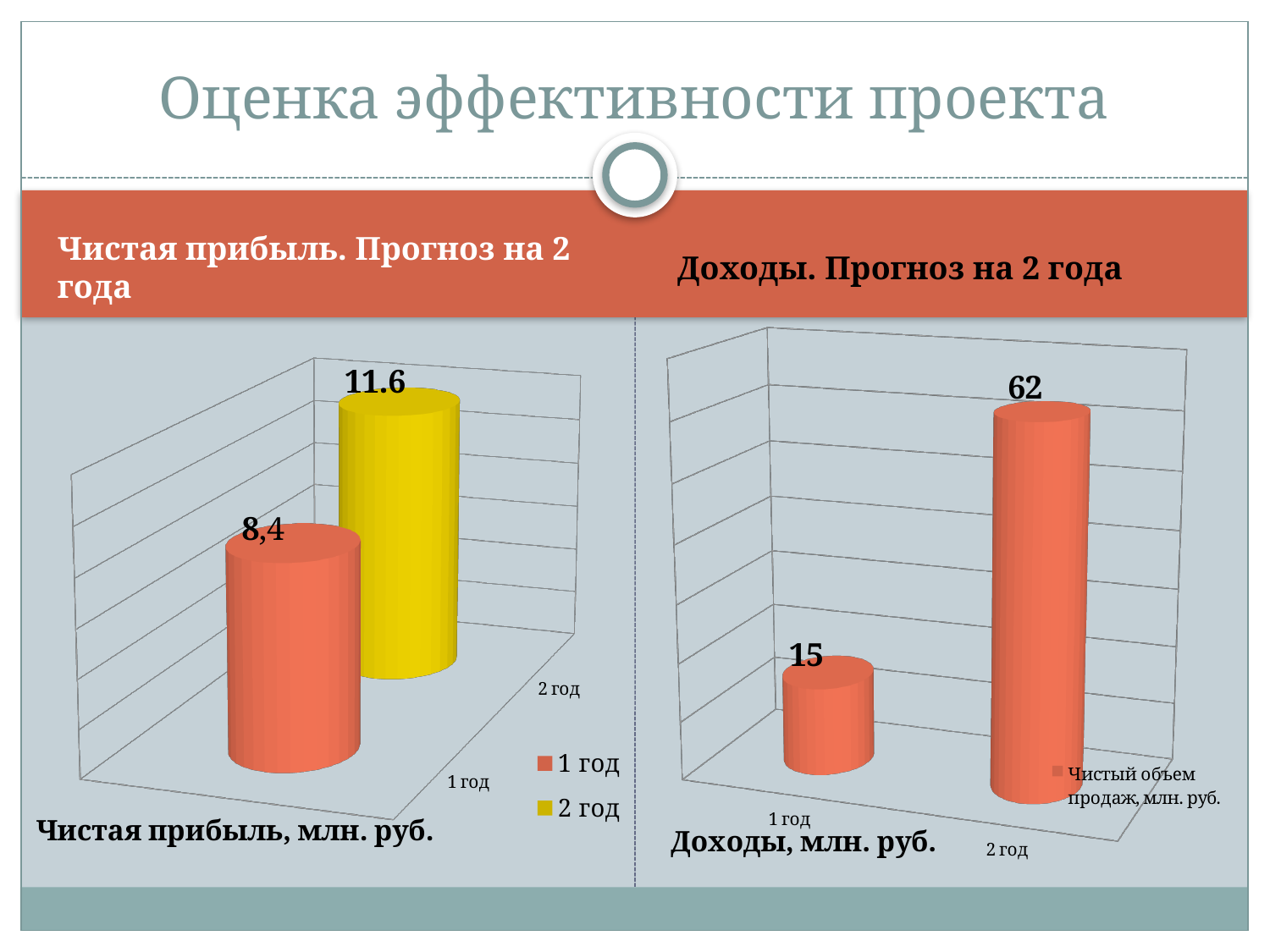
On the left chart (Чистая прибыль, млн. руб.), which year has the higher value? 2 год How many bars are plotted on the right chart (Доходы, млн. руб.)? 2 What is the legend entry on the right chart (Доходы, млн. руб.)? Чистый объем продаж, млн. руб. On the right chart (Доходы, млн. руб.), what is the value for 2 год? 62 On the right chart (Доходы, млн. руб.), what is the value for 1 год? 15 On the left chart (Чистая прибыль, млн. руб.), what is the value for 1 год? 8,4 On the right chart (Доходы, млн. руб.), which year has the lower value? 1 год On the right chart (Доходы, млн. руб.), what is the difference between the values for 2 год and 1 год? 47 What kind of chart is the right chart (Доходы, млн. руб.)? bar chart How many entries does the legend of the left chart (Чистая прибыль, млн. руб.) list? 2 On the left chart (Чистая прибыль, млн. руб.), is the value for 1 год larger or smaller than the value for 2 год? smaller On the left chart (Чистая прибыль, млн. руб.), what is the value for 2 год? 11.6